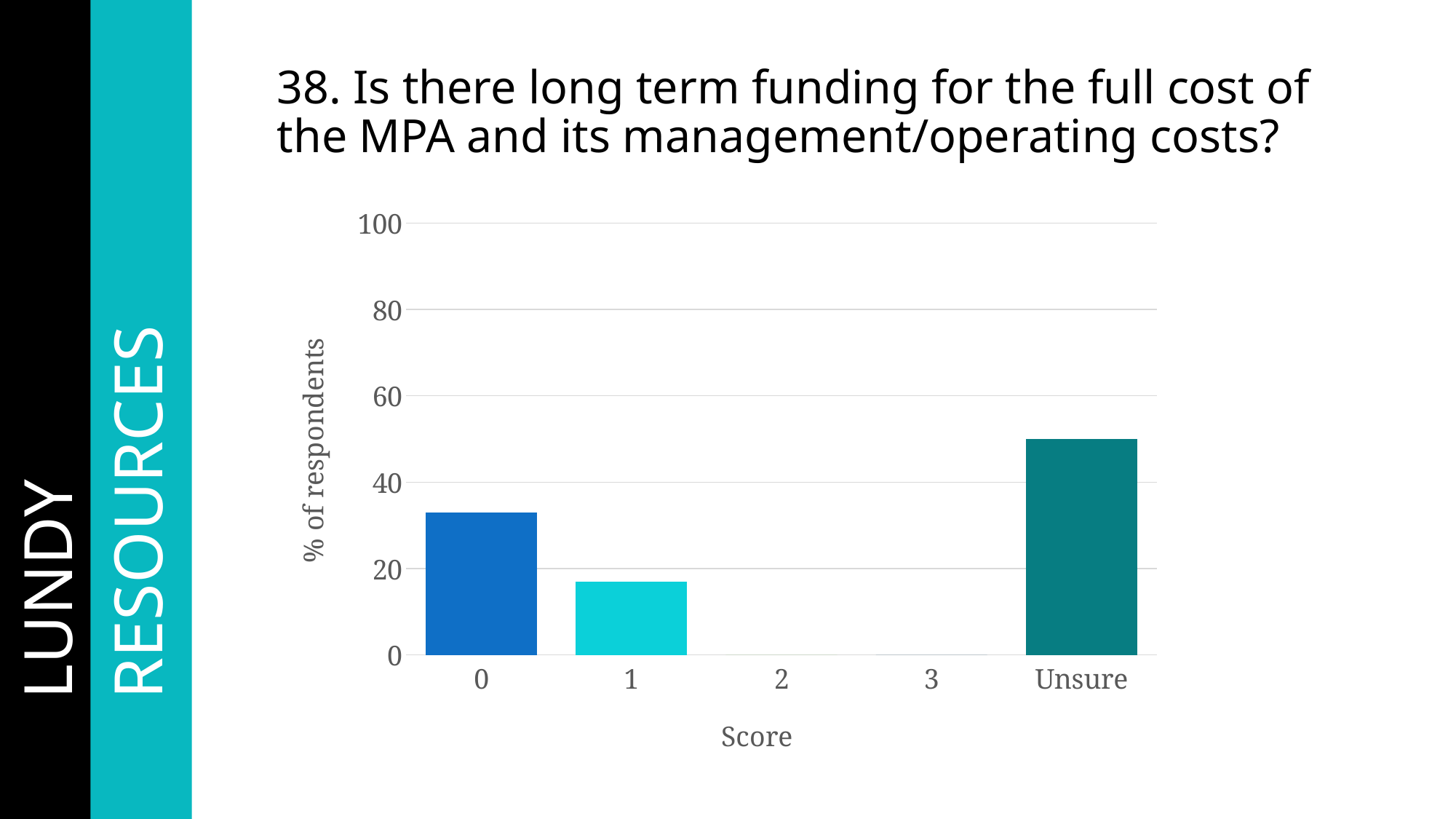
Is the value for score 0 greater or less than 40? less Which is larger, the value for Unsure or the value for score 0? Unsure What kind of chart is shown on the slide? bar chart Is the value for score 0 greater or less than 20? greater Is the value for Unsure greater or less than 60? less What is the label of the x axis? Score How many score categories are shown on the x axis? 5 What is the label of the y axis? % of respondents Which is larger, the value for score 0 or the value for score 1? 0 Which score category has the highest percentage of respondents? Unsure